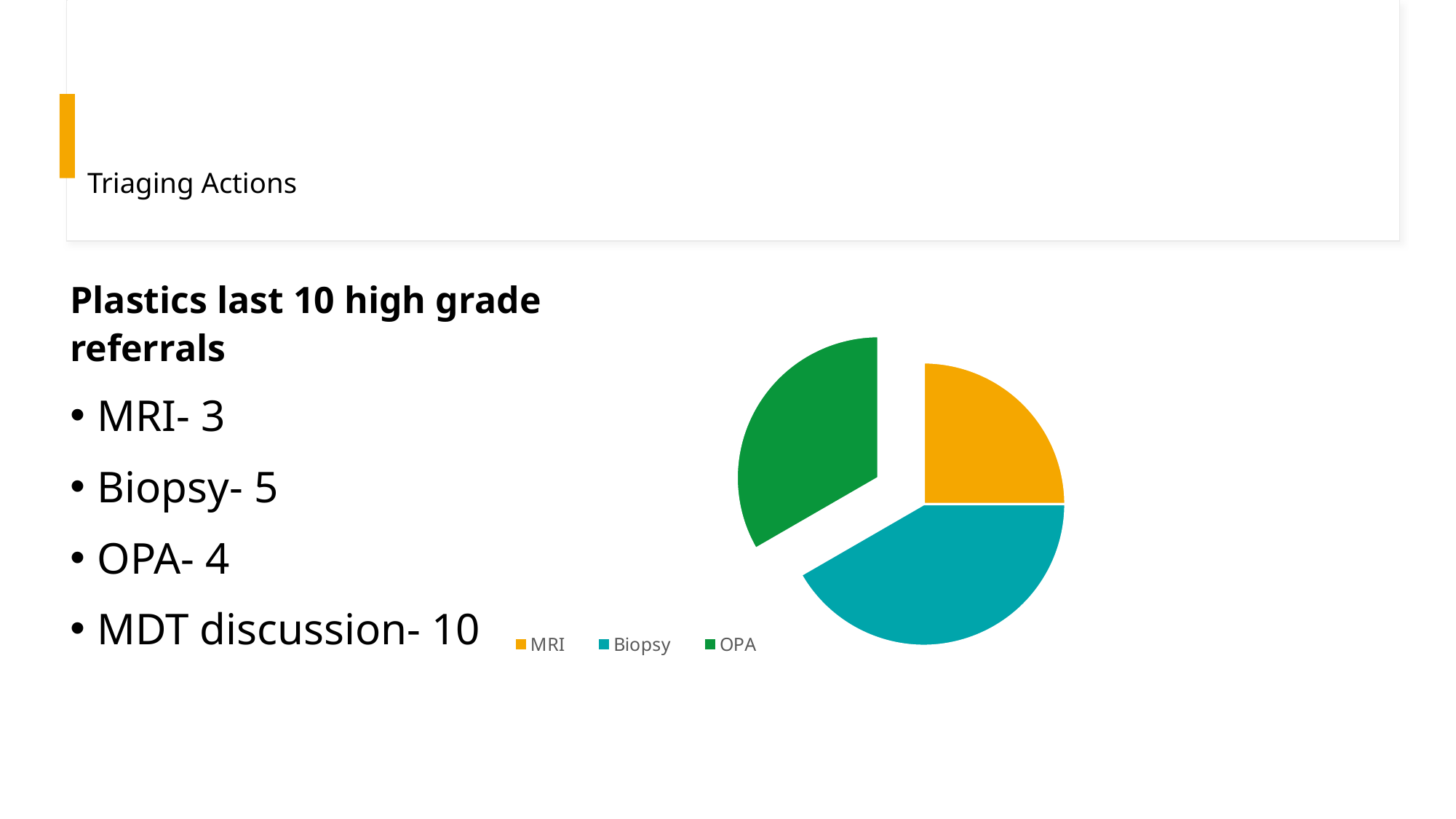
How many slices does the pie chart have? 3 What colour is the Biopsy slice in the pie chart? Teal Which slice is larger in the pie chart, Biopsy or OPA? Biopsy What is the value for MRI shown on the slide? 3 What kind of chart is shown on the slide? Pie chart What is the value for Biopsy shown on the slide? 5 Which category has the smallest slice in the pie chart? MRI Which category has the largest slice in the pie chart? Biopsy What share of the pie does the MRI slice represent? 25% How many entries does the pie chart's legend list? 3 What is the difference between the Biopsy and MRI values? 2 Which slice is larger in the pie chart, OPA or MRI? OPA